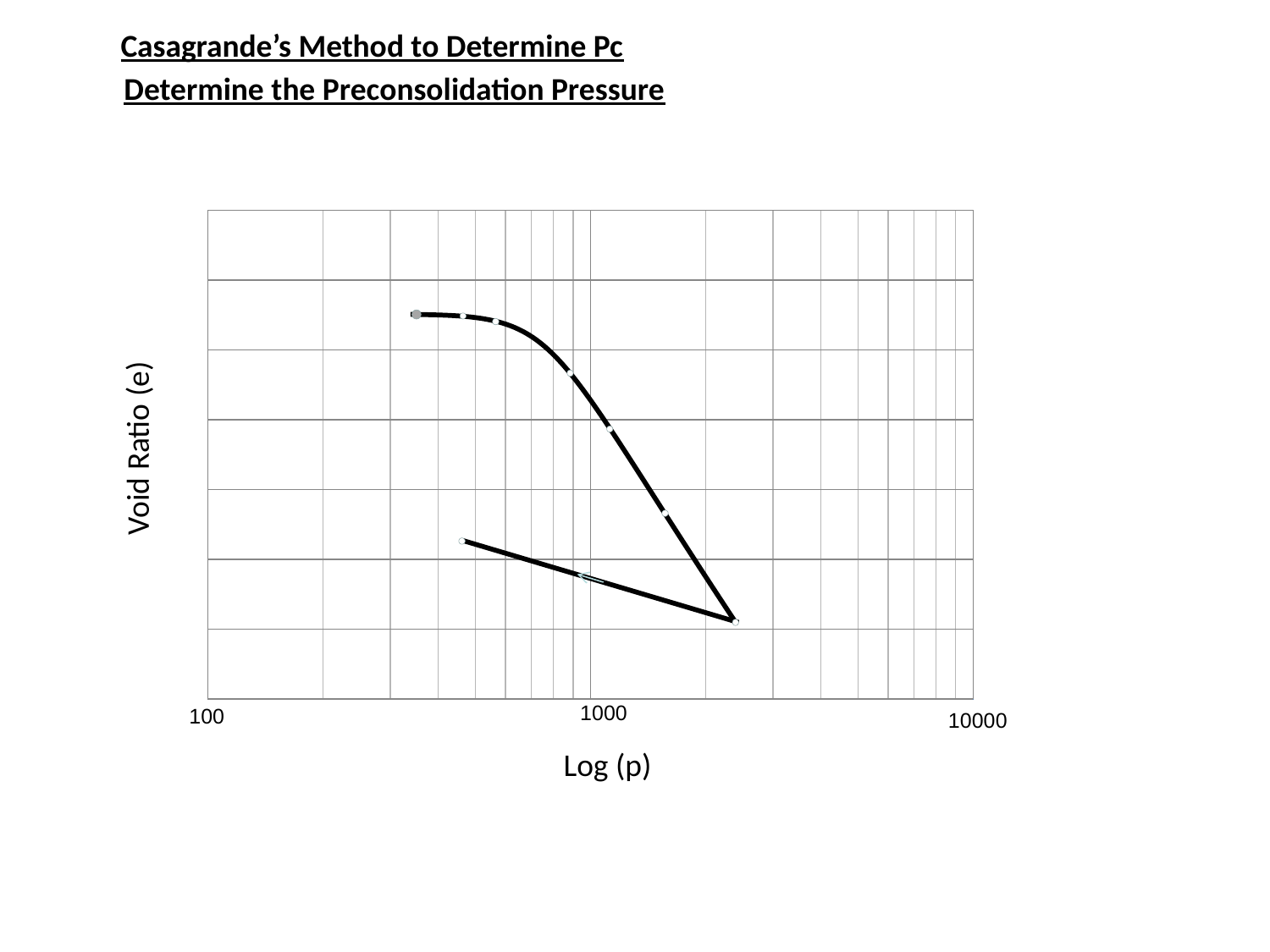
What kind of chart is shown on the slide? line chart How many tick labels are printed on the x axis of the chart? 3 Does the void ratio rise or fall as Log (p) increases along the main curve? fall What is the label of the x axis of the chart? Log (p) What is the label of the y axis of the chart? Void Ratio (e) What is the largest value labelled on the x axis of the chart? 10000 What is the smallest value labelled on the x axis of the chart? 100